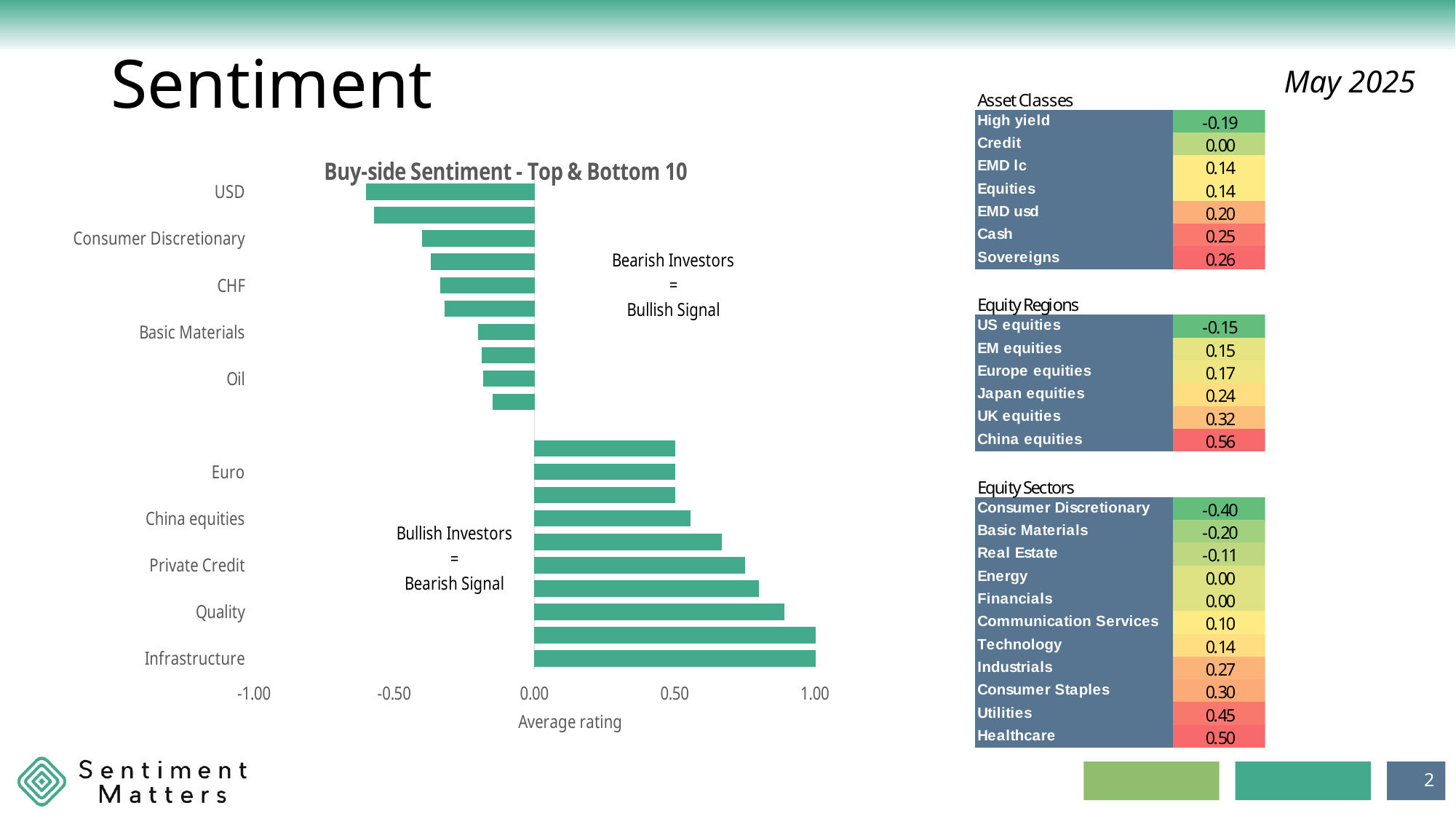
What is the title of the chart on the slide? Buy-side Sentiment - Top & Bottom 10 Is the value for Infrastructure greater or less than 0.50? greater How many bars are plotted in the chart? 20 Is the value for USD greater or less than -0.50? less Is the value for Consumer Discretionary greater or less than -0.50? greater What is the label of the horizontal axis of the chart? Average rating Which has the lower value, USD or Oil? USD Which has the larger value, Infrastructure or Euro? Infrastructure What type of chart is shown on the slide? bar chart